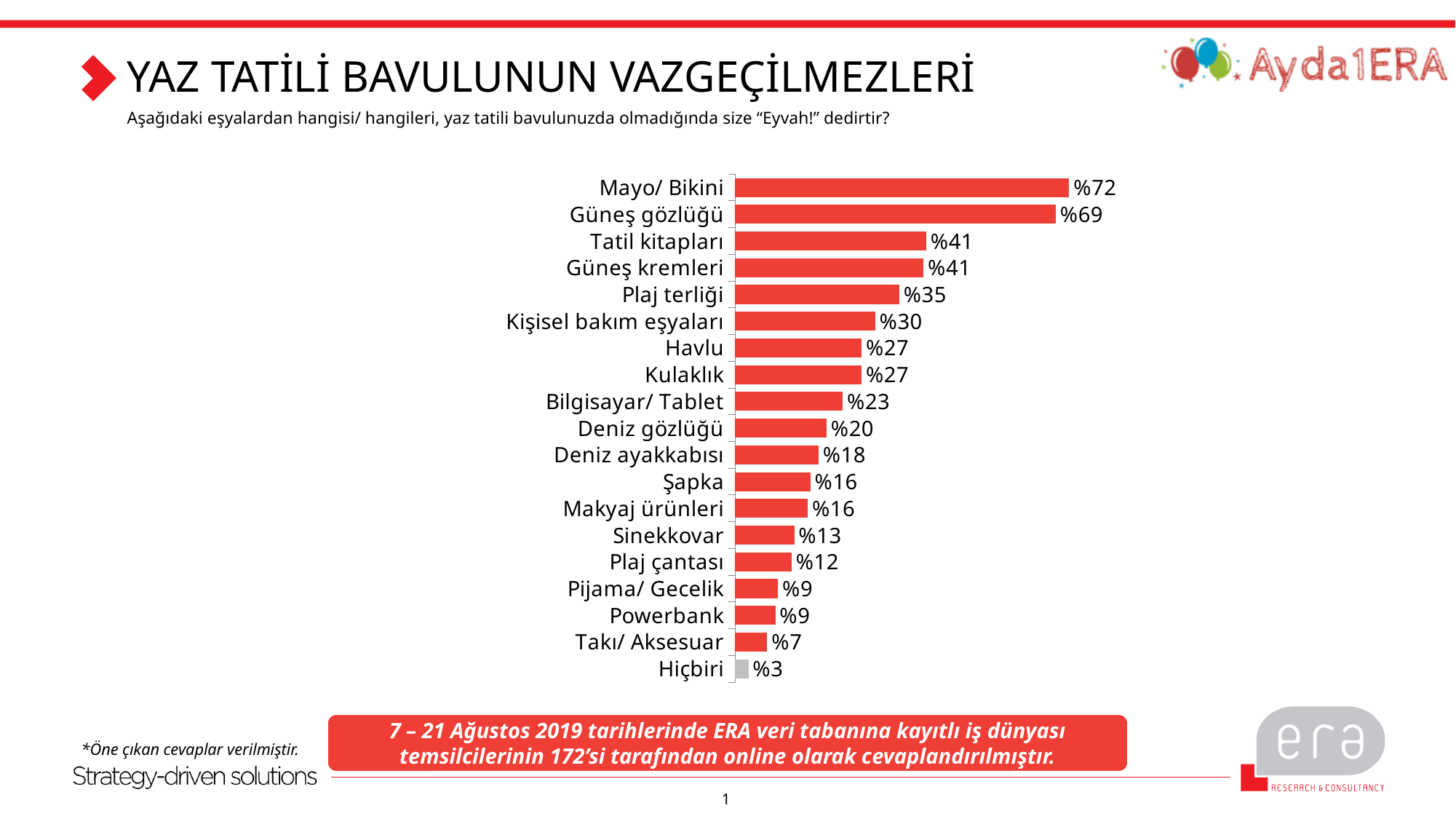
What is the difference between the values for Mayo/ Bikini and Güneş gözlüğü? %3 Which is larger, the value for Plaj çantası or the value for Takı/ Aksesuar? Plaj çantası What kind of chart is shown on the slide? Bar chart How many categories are shown in the chart? 19 Which category's bar is shown in grey rather than red? Hiçbiri Which category has the highest value? Mayo/ Bikini What is the value for Sinekkovar? %13 What is the value for Mayo/ Bikini? %72 What is the difference between the values for Tatil kitapları and Deniz gözlüğü? %21 Which is larger, the value for Kişisel bakım eşyaları or the value for Bilgisayar/ Tablet? Kişisel bakım eşyaları What is the value for Plaj terliği? %35 Which category has the lowest value? Hiçbiri